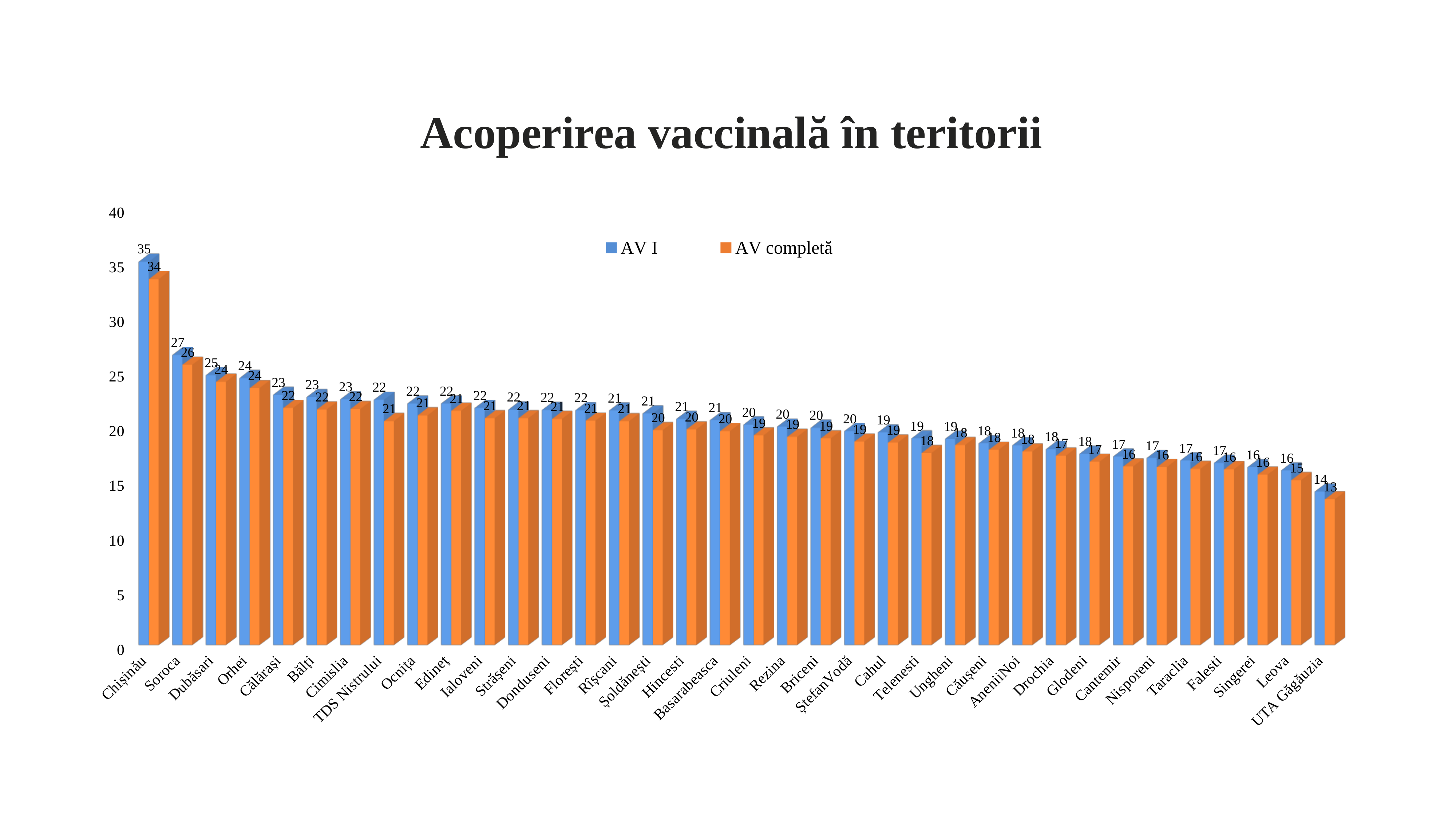
What kind of chart is shown on the slide? Bar chart What is the difference between the AV I values for Chișinău and Soroca? 8 Do the AV I values rise or fall moving from left to right along the x axis? Fall How many series does the legend list? 2 What is the AV completă value for UTA Găgăuzia? 13 How many territories are shown on the x axis? 36 Which is larger: the AV I value for Orhei or the AV I value for Leova? Orhei What is the AV I value for Cahul? 19 Which territory has the highest AV I value? Chișinău What is the AV completă value for Soroca? 26 What is the AV I value for Chișinău? 35 Which territory has the lowest AV completă value? UTA Găgăuzia